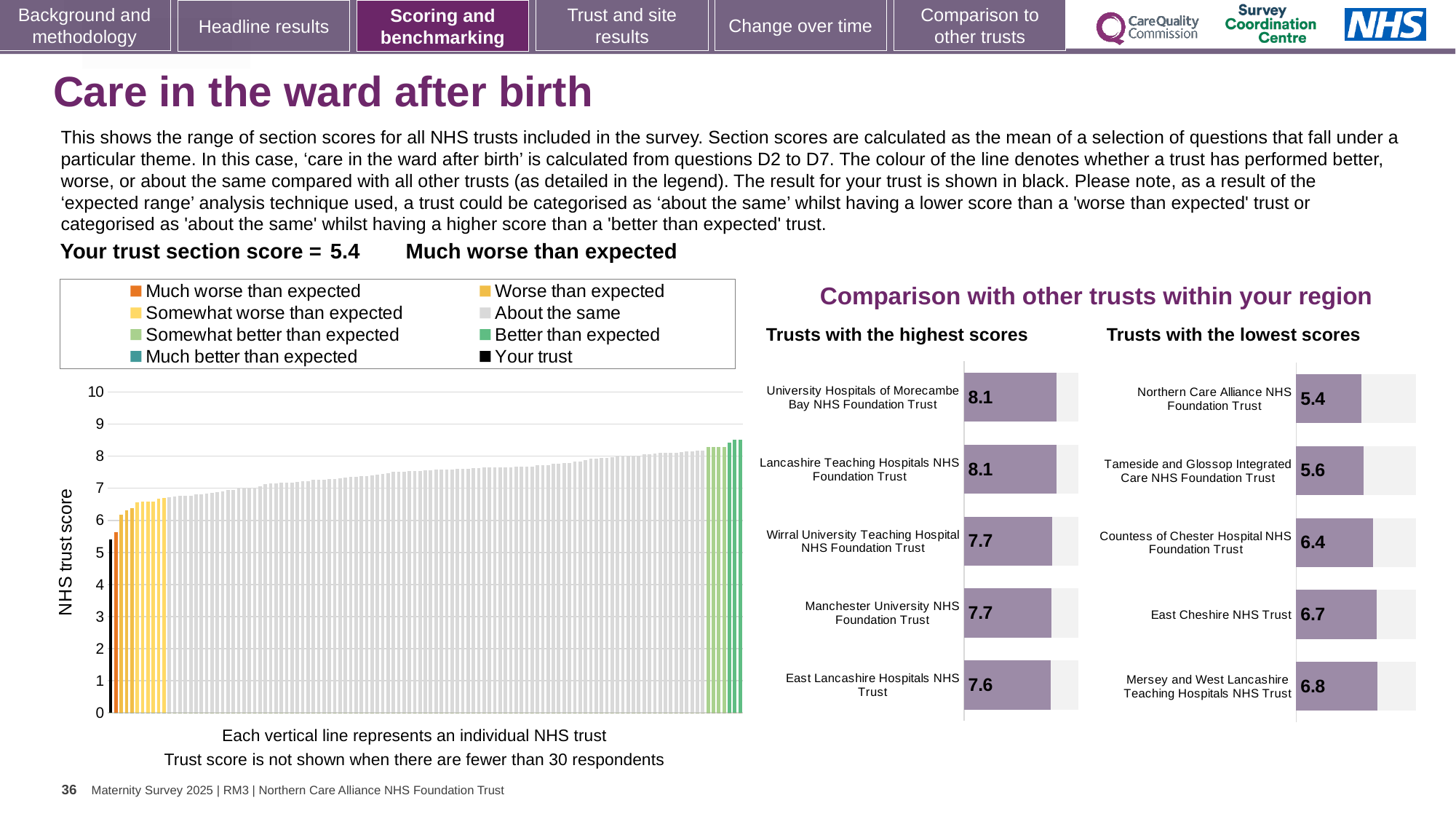
In the 'Trusts with the lowest scores' chart, what is the difference between the scores of Mersey and West Lancashire Teaching Hospitals NHS Trust and Northern Care Alliance NHS Foundation Trust? 1.4 In the 'Trusts with the lowest scores' chart, which trust has the highest score? Mersey and West Lancashire Teaching Hospitals NHS Trust Which has the higher score: Wirral University Teaching Hospital NHS Foundation Trust in the highest scores chart, or Tameside and Glossop Integrated Care NHS Foundation Trust in the lowest scores chart? Wirral University Teaching Hospital NHS Foundation Trust In the 'Trusts with the highest scores' chart, what is the difference between the scores of University Hospitals of Morecambe Bay NHS Foundation Trust and East Lancashire Hospitals NHS Trust? 0.5 In the 'Trusts with the lowest scores' chart, what is the score for Countess of Chester Hospital NHS Foundation Trust? 6.4 In the 'Trusts with the lowest scores' chart, which trust has the lowest score? Northern Care Alliance NHS Foundation Trust In the 'Trusts with the highest scores' chart, what is the score for East Lancashire Hospitals NHS Trust? 7.6 What kind of chart is the 'NHS trust score' chart on the left of the slide? bar chart How many entries does the legend above the 'NHS trust score' chart list? 8 What is the section score for your trust shown on the slide? 5.4 How many trusts are shown in the 'Trusts with the highest scores' chart? 5 In the 'NHS trust score' chart on the left, do the values rise or fall from left to right? rise